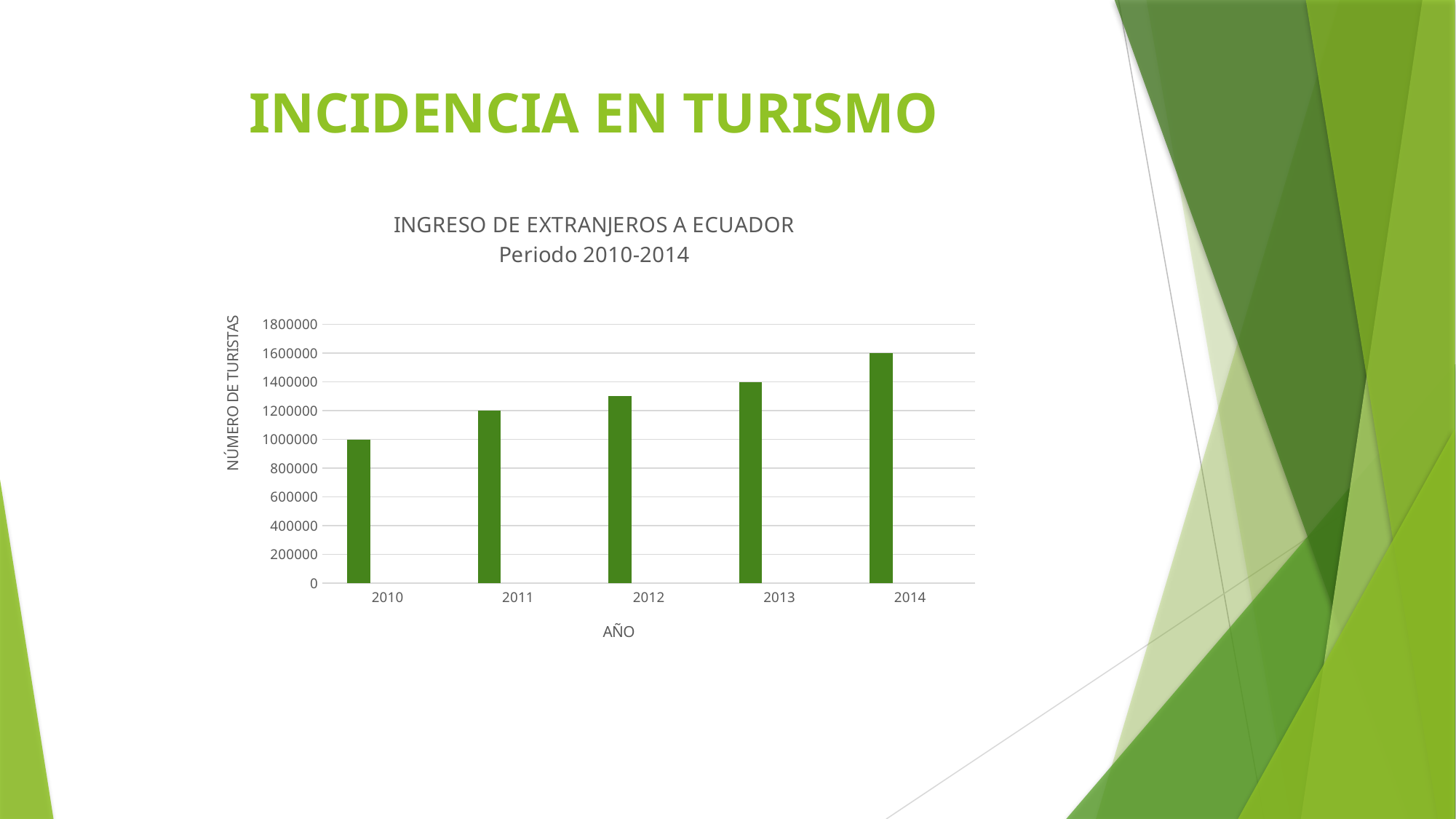
Which year has the highest number of tourists? 2014 What is the number of tourists for 2013? 1400000 What is the number of tourists for 2010? 1000000 What is the title of the chart? INGRESO DE EXTRANJEROS A ECUADOR Periodo 2010-2014 How many years are shown on the x axis of the chart? 5 What is the number of tourists for 2014? 1600000 Which year has a larger value, 2011 or 2013? 2013 What type of chart is shown on the slide? Bar chart Is the value for 2012 greater or less than 1200000? greater Do the values rise or fall from 2010 to 2014? Rise What is the difference between the values for 2014 and 2010? 600000 Which year has the lowest number of tourists? 2010